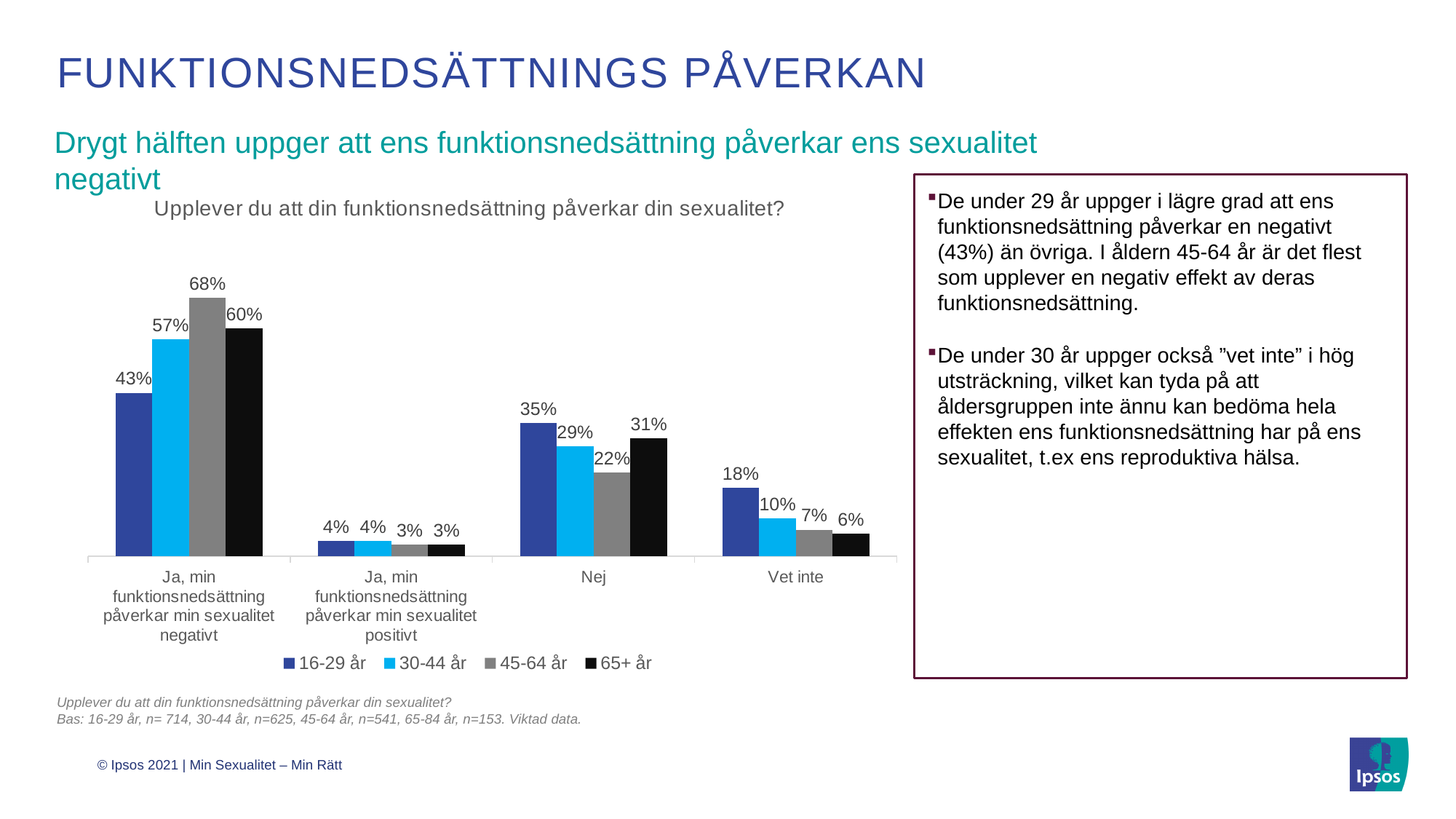
What kind of chart is shown on the slide? Bar chart How many categories are shown on the x axis of the chart? 4 What is the value for the 45-64 år series in the 'Ja, min funktionsnedsättning påverkar min sexualitet negativt' category? 68% In the 'Nej' category, which is larger: the value for 16-29 år or the value for 30-44 år? 16-29 år What is the difference between the 45-64 år and 16-29 år values in the 'Ja, min funktionsnedsättning påverkar min sexualitet negativt' category? 25% What is the value for the 16-29 år series in the 'Vet inte' category? 18% Which age group has the highest value in the 'Ja, min funktionsnedsättning påverkar min sexualitet negativt' category? 45-64 år What is the title of the chart? Upplever du att din funktionsnedsättning påverkar din sexualitet? How many series does the legend list? 4 What is the difference between the 16-29 år and 30-44 år values in the 'Vet inte' category? 8% What is the value for the 65+ år series in the 'Nej' category? 31% Which age group has the lowest value in the 'Vet inte' category? 65+ år